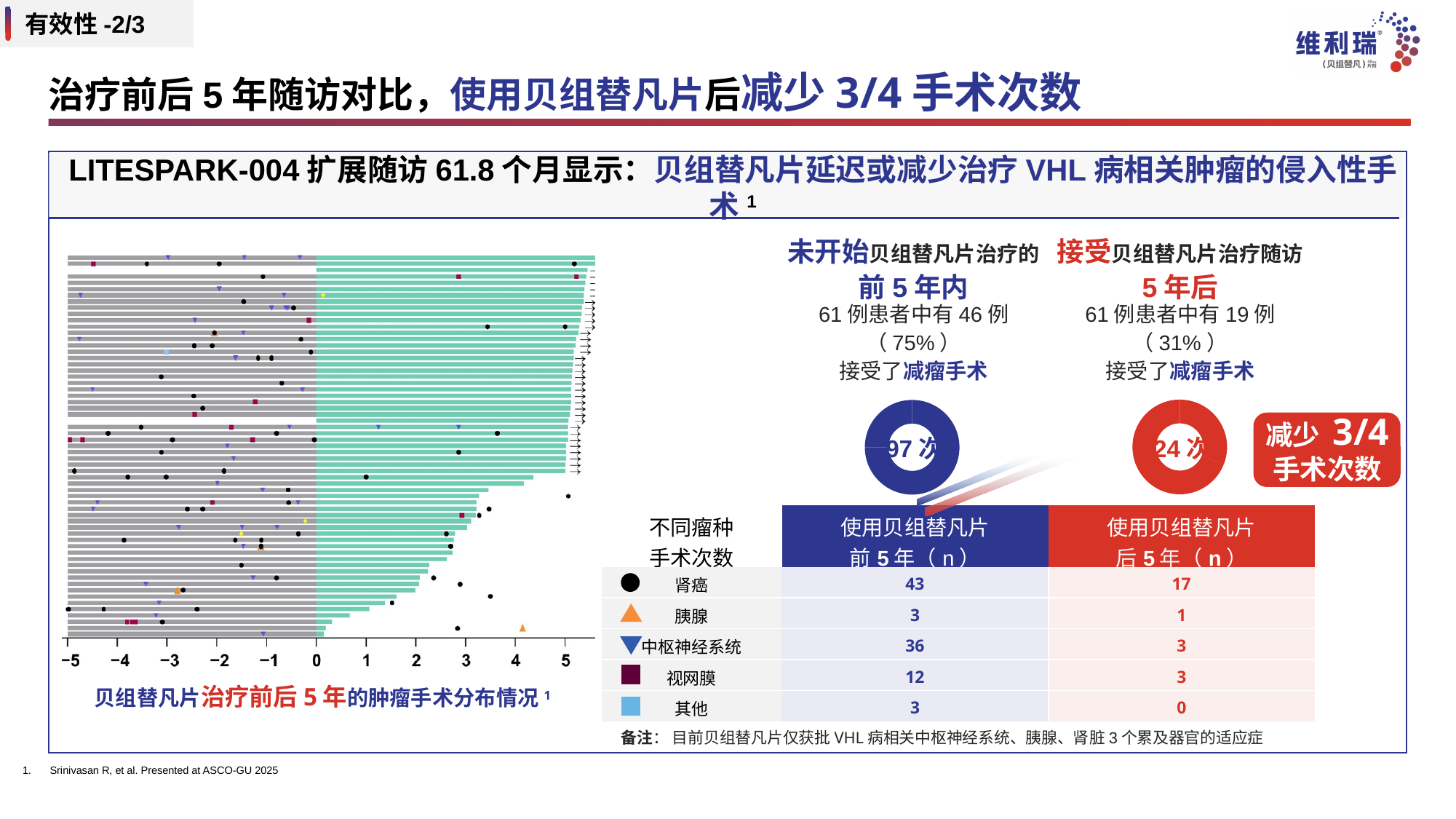
What is the difference in surgery counts between the blue donut chart (97 次) and the red donut chart (24 次)? 73 次 On the red donut chart (5年后), how many surgeries (次) are shown in the centre? 24 次 What kind of chart is the left-hand plot with grey and teal horizontal bars? Bar chart (swimmer plot) Comparing the two donut charts, which period has more surgeries: the 5 years before treatment (blue) or the 5 years after (red)? 5 years before treatment (blue, 97 次) In the table below the donut charts, how many 中枢神经系统 surgeries were there in the 5 years after treatment? 3 On the blue donut chart (前5年内), how many surgeries (次) are shown in the centre? 97 次 In the table below the donut charts, how many 肾癌 surgeries were there in the 5 years before treatment? 43 On the left-hand bar chart, what is the highest value shown on the x axis? 5 How many tumour types are listed in the legend/table beside the donut charts? 5 On the left-hand bar chart, what is the lowest value shown on the x axis? -5 In the table below the donut charts, which tumour type had the most surgeries in the 5 years before treatment? 肾癌 In the table below the donut charts, which tumour type had the fewest surgeries in the 5 years after treatment? 其他